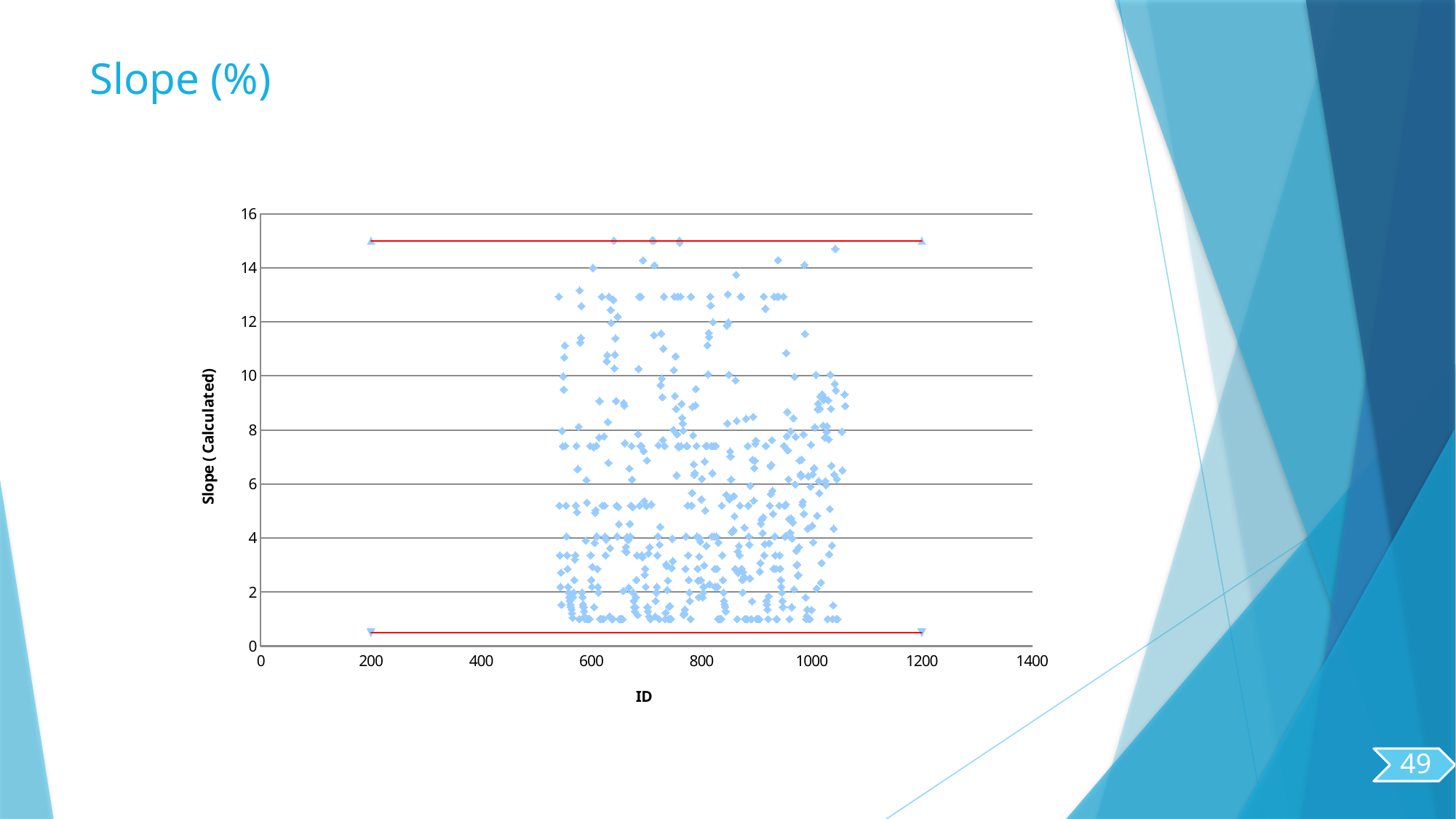
What is the highest value shown on the horizontal axis? 1400 What kind of chart is shown on the slide? scatter chart Is the lower red horizontal line greater or less than 2 on the vertical axis? less What is the label of the vertical axis? Slope ( Calculated) What is the title of the chart on the slide? Slope (%) Is the upper red horizontal line greater or less than 14 on the vertical axis? greater Is the upper red horizontal line greater or less than 16 on the vertical axis? less